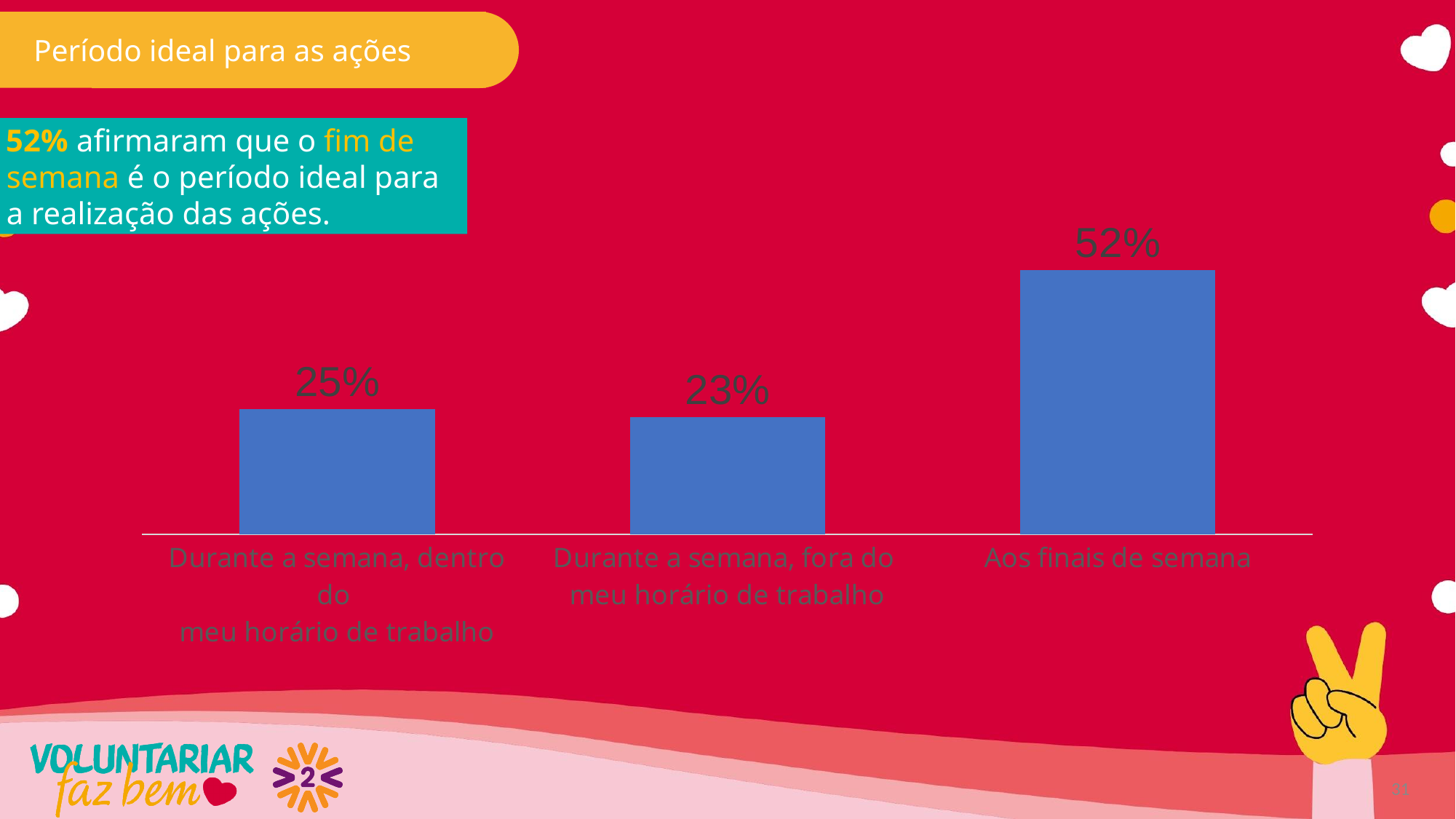
Which category has the lowest value? Durante a semana, fora do meu horário de trabalho Which is larger: the value for "Aos finais de semana" or the value for "Durante a semana, fora do meu horário de trabalho"? Aos finais de semana What is the value for "Durante a semana, dentro do meu horário de trabalho"? 25% Which category has the highest value? Aos finais de semana What is the difference between the value for "Aos finais de semana" and the value for "Durante a semana, dentro do meu horário de trabalho"? 27% What is the difference between the value for "Durante a semana, dentro do meu horário de trabalho" and the value for "Durante a semana, fora do meu horário de trabalho"? 2% What is the value for "Aos finais de semana"? 52% What colour are the bars in the chart? Blue What is the value for "Durante a semana, fora do meu horário de trabalho"? 23% How many categories are shown in the chart? 3 What is the title shown at the top of the slide for this chart? Período ideal para as ações What kind of chart is shown on the slide? Bar chart